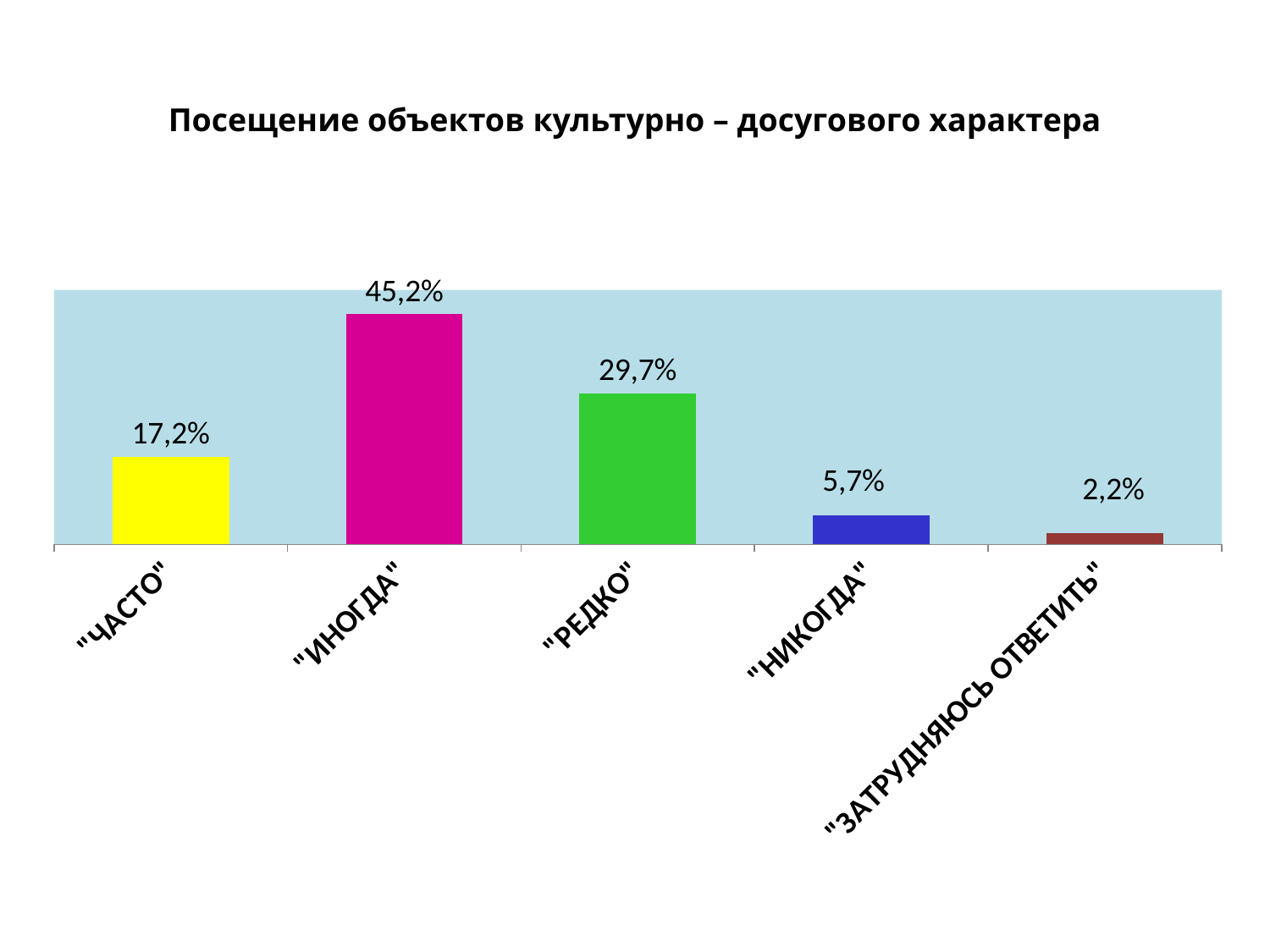
How many categories are shown on the chart? 5 Which category has the highest value? "ИНОГДА" Which is larger, the value for "РЕДКО" or the value for "ЧАСТО"? "РЕДКО" What is the difference between the values for "ИНОГДА" and "РЕДКО"? 15,5% What is the value for "ЗАТРУДНЯЮСЬ ОТВЕТИТЬ"? 2,2% What is the title of the chart? Посещение объектов культурно – досугового характера What is the difference between the values for "ЧАСТО" and "НИКОГДА"? 11,5% Which category has the lowest value? "ЗАТРУДНЯЮСЬ ОТВЕТИТЬ" What is the value for "ЧАСТО"? 17,2% What kind of chart is shown on the slide? Bar chart What is the value for "ИНОГДА"? 45,2% What is the value for "НИКОГДА"? 5,7%